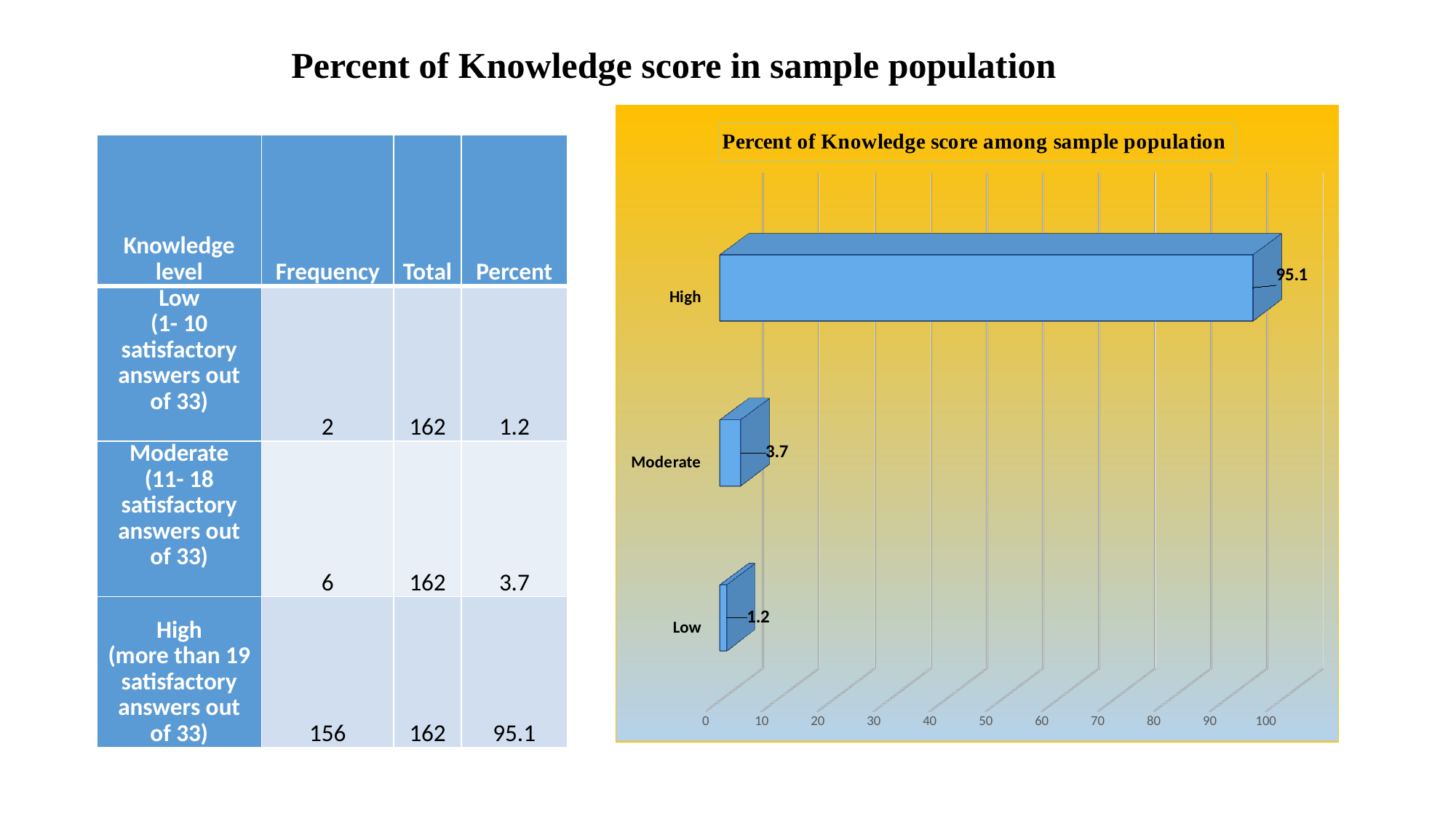
How many categories are shown in the chart? 3 Which knowledge level has the lowest value in the chart? Low What is the title of the chart? Percent of Knowledge score among sample population What is the difference between the values for High and Moderate? 91.4 Is the value for High greater or less than 90? greater Which knowledge level has the highest value in the chart? High What is the difference between the values for Moderate and Low? 2.5 What is the value for Low in the chart? 1.2 Which is larger, the value for Moderate or the value for Low? Moderate What kind of chart is shown on the slide? bar chart What is the value for High in the chart? 95.1 What is the value for Moderate in the chart? 3.7